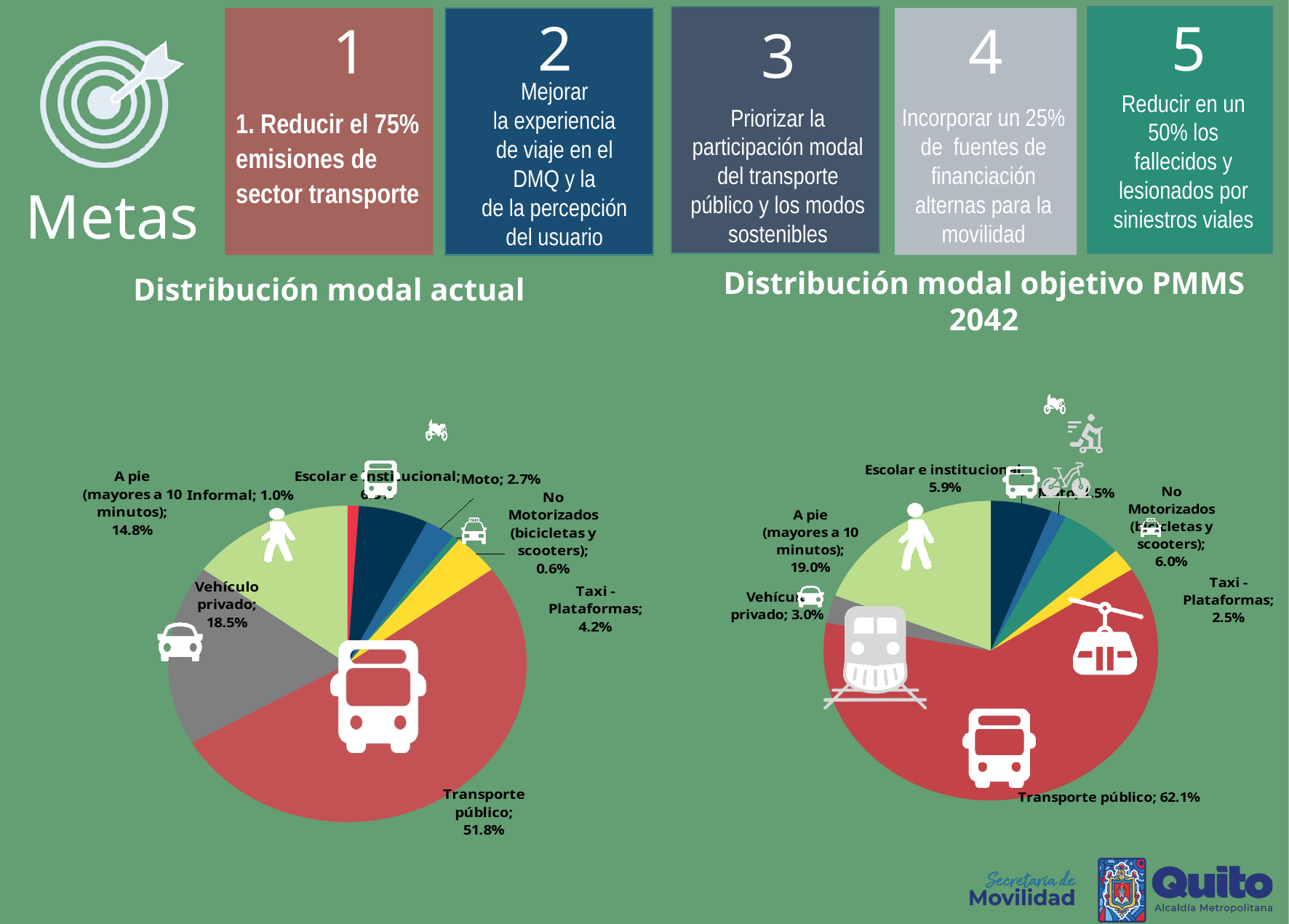
In the 'Distribución modal actual' pie chart, what is the share for Taxi - Plataformas? 4.2% In the 'Distribución modal objetivo PMMS 2042' pie chart, what is the share for A pie (mayores a 10 minutos)? 19.0% In the 'Distribución modal actual' pie chart, what is the share for Vehículo privado? 18.5% In the 'Distribución modal actual' pie chart, what is the share for A pie (mayores a 10 minutos)? 14.8% In the 'Distribución modal objetivo PMMS 2042' pie chart, what is the share for No Motorizados (bicicletas y scooters)? 6.0% In the 'Distribución modal actual' pie chart, which category has the smallest share? No Motorizados (bicicletas y scooters) What kind of chart is used for 'Distribución modal actual'? Pie chart In the 'Distribución modal objetivo PMMS 2042' pie chart, which category has the largest share? Transporte público In the 'Distribución modal actual' pie chart, what is the share for Transporte público? 51.8% In the 'Distribución modal objetivo PMMS 2042' pie chart, what is the share for Transporte público? 62.1% In the 'Distribución modal actual' pie chart, what is the difference between the shares of Vehículo privado and A pie? 3.7% In the 'Distribución modal objetivo PMMS 2042' pie chart, which is larger: Vehículo privado or Escolar e institucional? Escolar e institucional